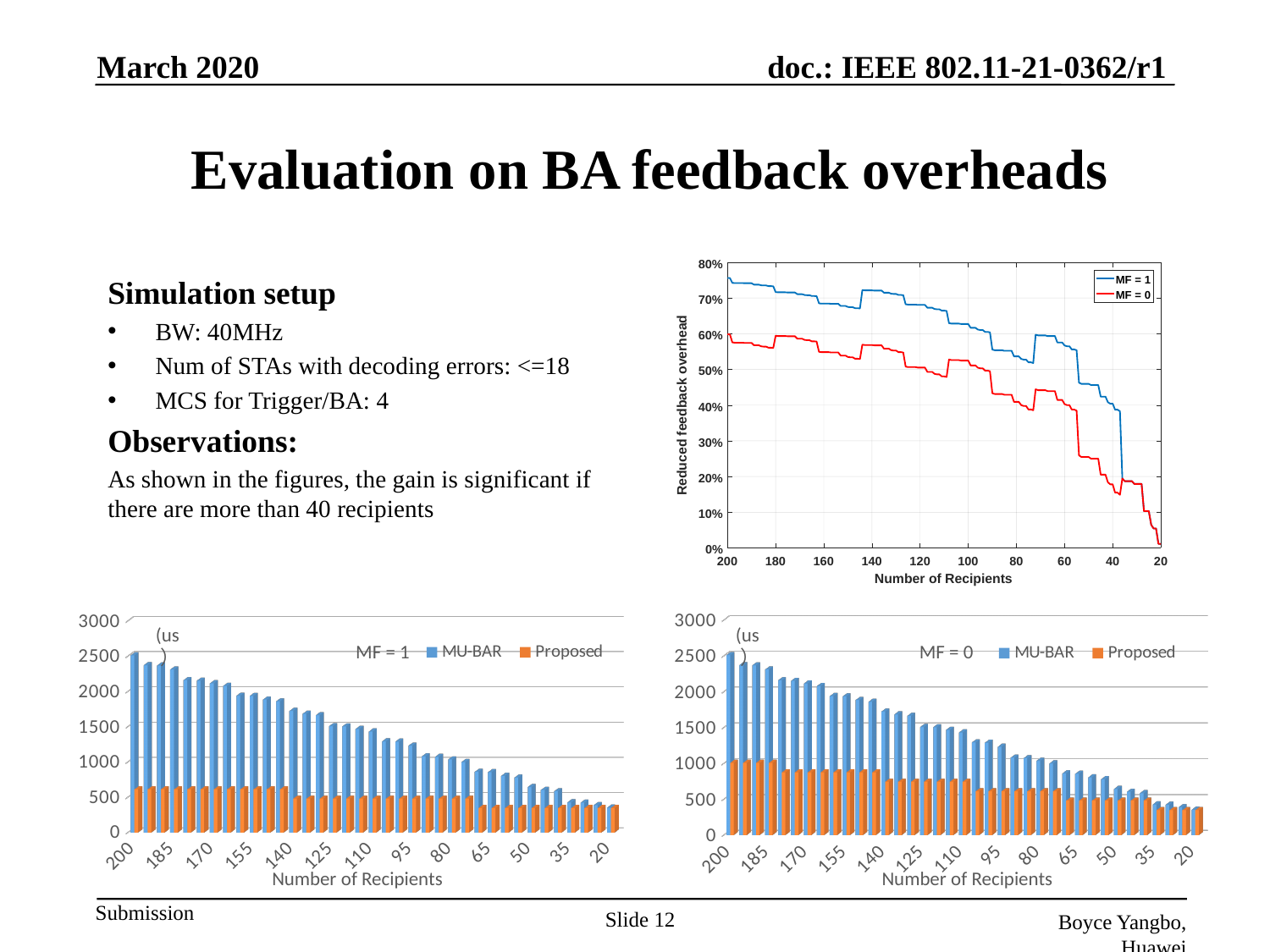
In the bottom-left 'MF = 1' bar chart, is the MU-BAR value at 200 recipients greater or less than 2000? greater In the top-right line chart, is the value of MF = 1 at 20 recipients greater or less than 10%? less In the top-right line chart, which series is drawn in red? MF = 0 In the top-right line chart, do the values rise or fall moving from left to right along the x axis? fall In the top-right line chart, is the value of MF = 0 at 120 recipients greater or less than 40%? greater What kind of chart is the top-right chart titled with the y-axis 'Reduced feedback overhead'? line chart What kind of chart is the bottom-left chart labelled 'MF = 1'? bar chart How many series does the legend of the top-right line chart list? 2 In the top-right line chart, at 100 recipients, which series has the larger value, MF = 1 or MF = 0? MF = 1 In the bottom-left 'MF = 1' bar chart, at 200 recipients, which series is larger, MU-BAR or Proposed? MU-BAR